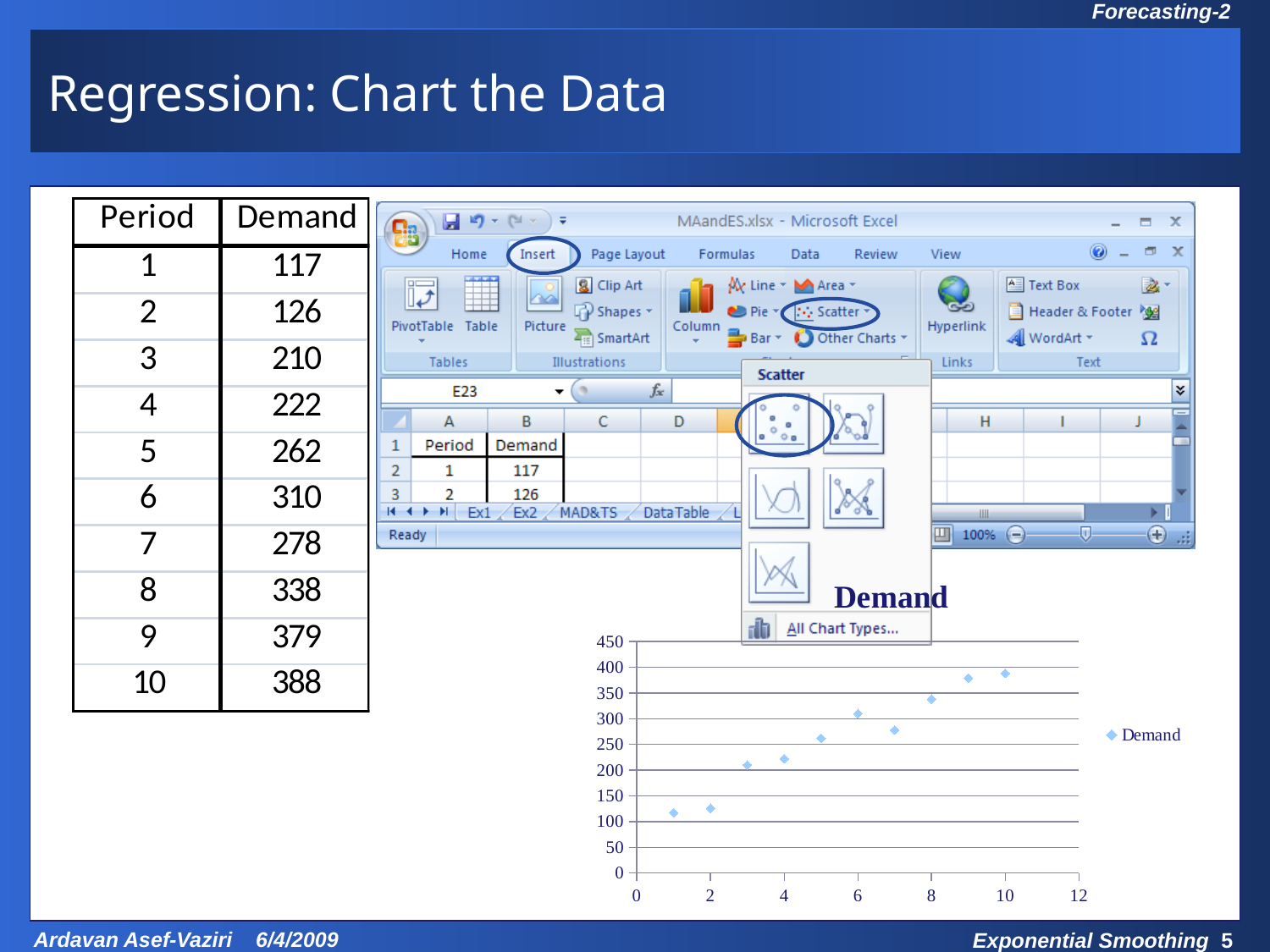
What kind of chart is the 'Demand' chart on the slide? scatter chart Overall, do the values in the 'Demand' chart rise or fall as the period increases? rise In the 'Demand' chart, is the value for period 10 greater or less than 350? greater In the 'Demand' chart, is the value for period 1 greater or less than 150? less In the 'Demand' chart, which period has the lowest demand? 1 In the 'Demand' chart, is the value for period 6 greater or less than 300? greater In the 'Demand' chart, is the demand for period 7 larger or smaller than the demand for period 6? smaller How many series does the legend of the 'Demand' chart list? 1 What is the title of the scatter chart on the slide? Demand How many data points are plotted in the 'Demand' scatter chart? 10 In the 'Demand' chart, which period has the highest demand? 10 What is the maximum value shown on the vertical axis of the 'Demand' chart? 450